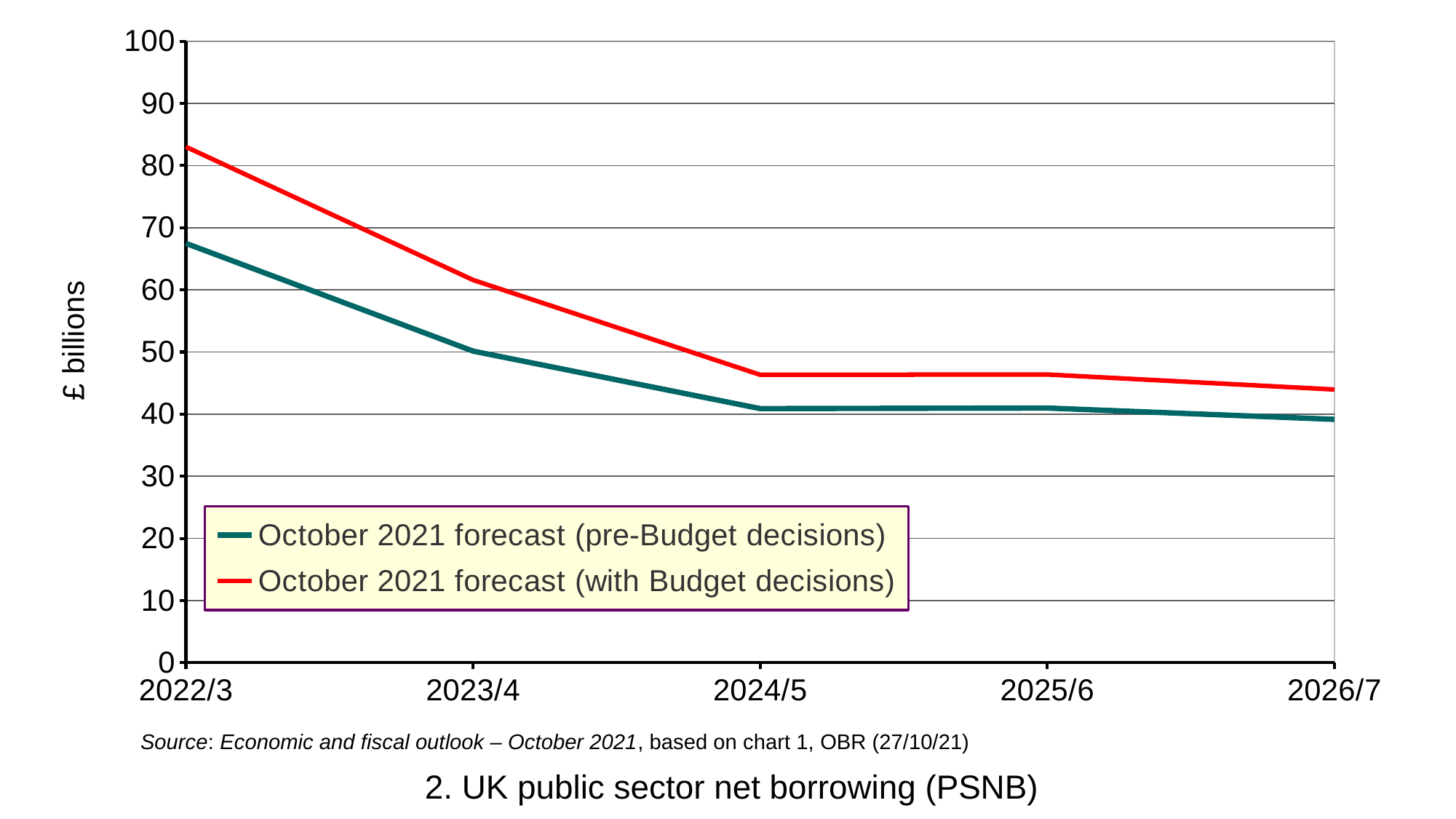
Do the values of the October 2021 forecast (with Budget decisions) series rise or fall from 2022/3 to 2026/7? fall In which year is the October 2021 forecast (with Budget decisions) series at its highest? 2022/3 What is the label on the y axis? £ billions Is the value for the October 2021 forecast (pre-Budget decisions) in 2022/3 greater or less than 60? greater What kind of chart is shown on the slide? line chart In which year is the October 2021 forecast (with Budget decisions) series at its lowest? 2026/7 How many fiscal years are plotted along the x axis? 5 In 2022/3, which series is higher: the pre-Budget decisions forecast or the with Budget decisions forecast? October 2021 forecast (with Budget decisions) Is the value for the October 2021 forecast (with Budget decisions) in 2022/3 greater or less than 70? greater Is the value for the October 2021 forecast (with Budget decisions) in 2026/7 greater or less than 50? less How many series does the legend list? 2 What is the title of the chart? 2. UK public sector net borrowing (PSNB)